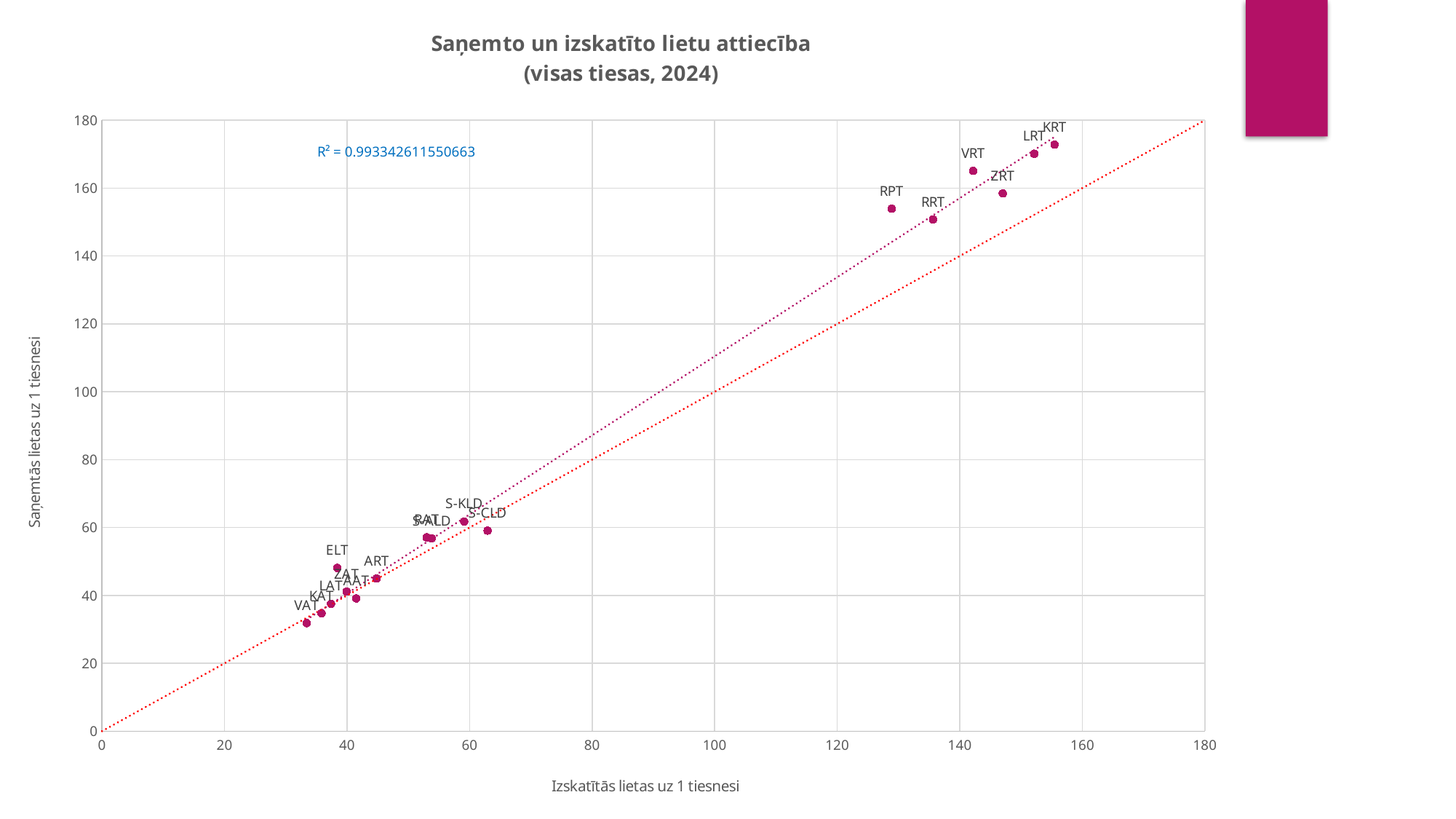
Which labeled point has the lowest value on the vertical axis (Saņemtās lietas uz 1 tiesnesi)? VAT Is the vertical-axis value for ELT greater or less than 60? less Is the horizontal-axis value for RPT greater or less than 120? greater Is the vertical-axis value for RRT greater or less than 160? less What is the label of the horizontal axis? Izskatītās lietas uz 1 tiesnesi What R² value is printed on the chart? R² = 0.993342611550663 What is the title of the chart? Saņemto un izskatīto lietu attiecība (visas tiesas, 2024) Which labeled point has the highest value on the vertical axis (Saņemtās lietas uz 1 tiesnesi)? KRT What kind of chart is shown on the slide? scatter chart Which has the larger vertical-axis value, VRT or ZRT? VRT